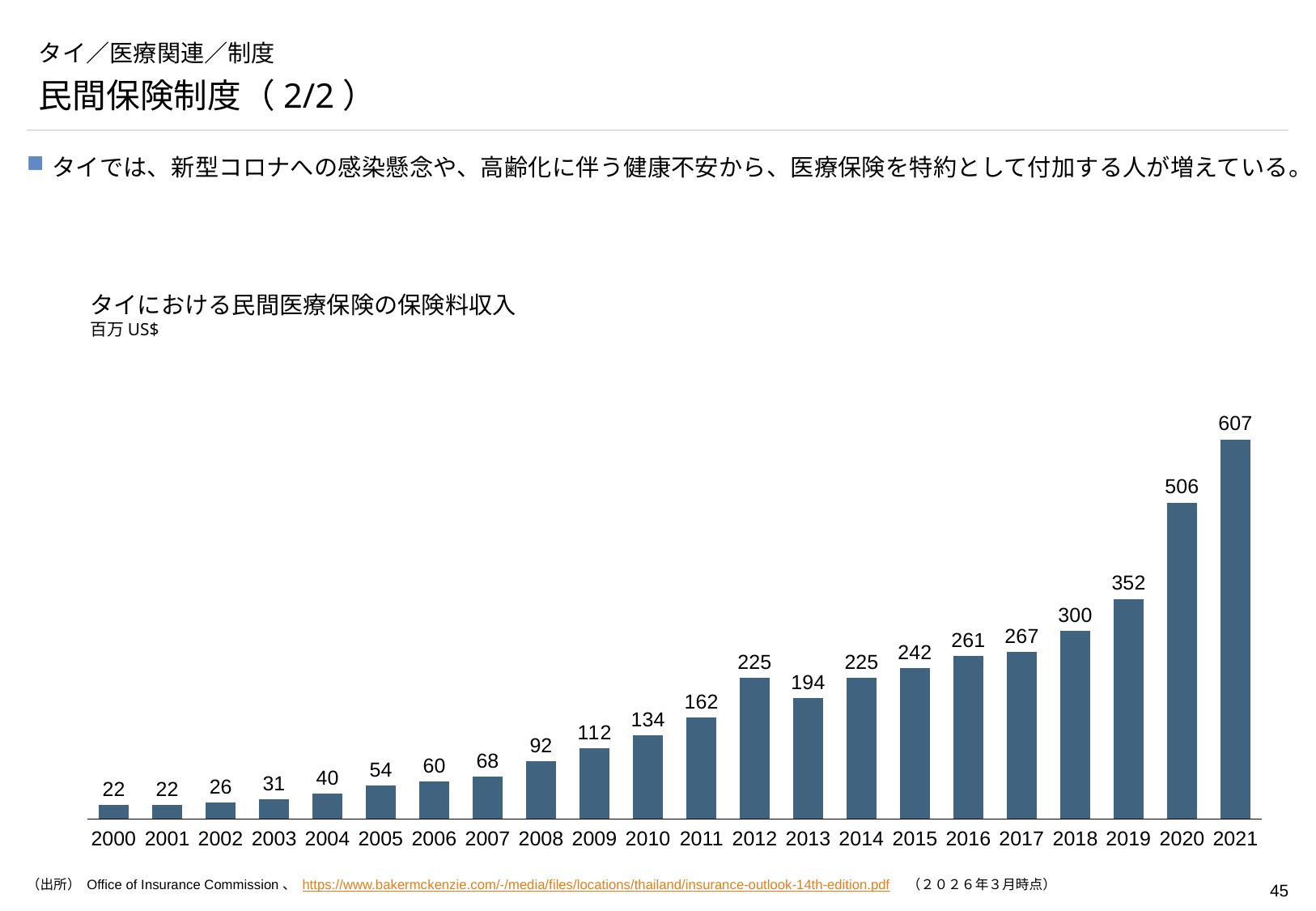
Which is larger, the value for 2013 or the value for 2014? 2014 What is the value for 2021? 607 What is the difference between the values for 2013 and 2012? 31 How many years are shown on the x axis? 22 Do the values generally rise or fall from 2000 to 2021? rise Which year has the highest value? 2021 What kind of chart is this? bar chart What is the difference between the values for 2021 and 2020? 101 What is the value for 2012? 225 What unit is stated below the chart title? 百万 US$ What is the lowest value shown in the chart? 22 What is the value for 2005? 54